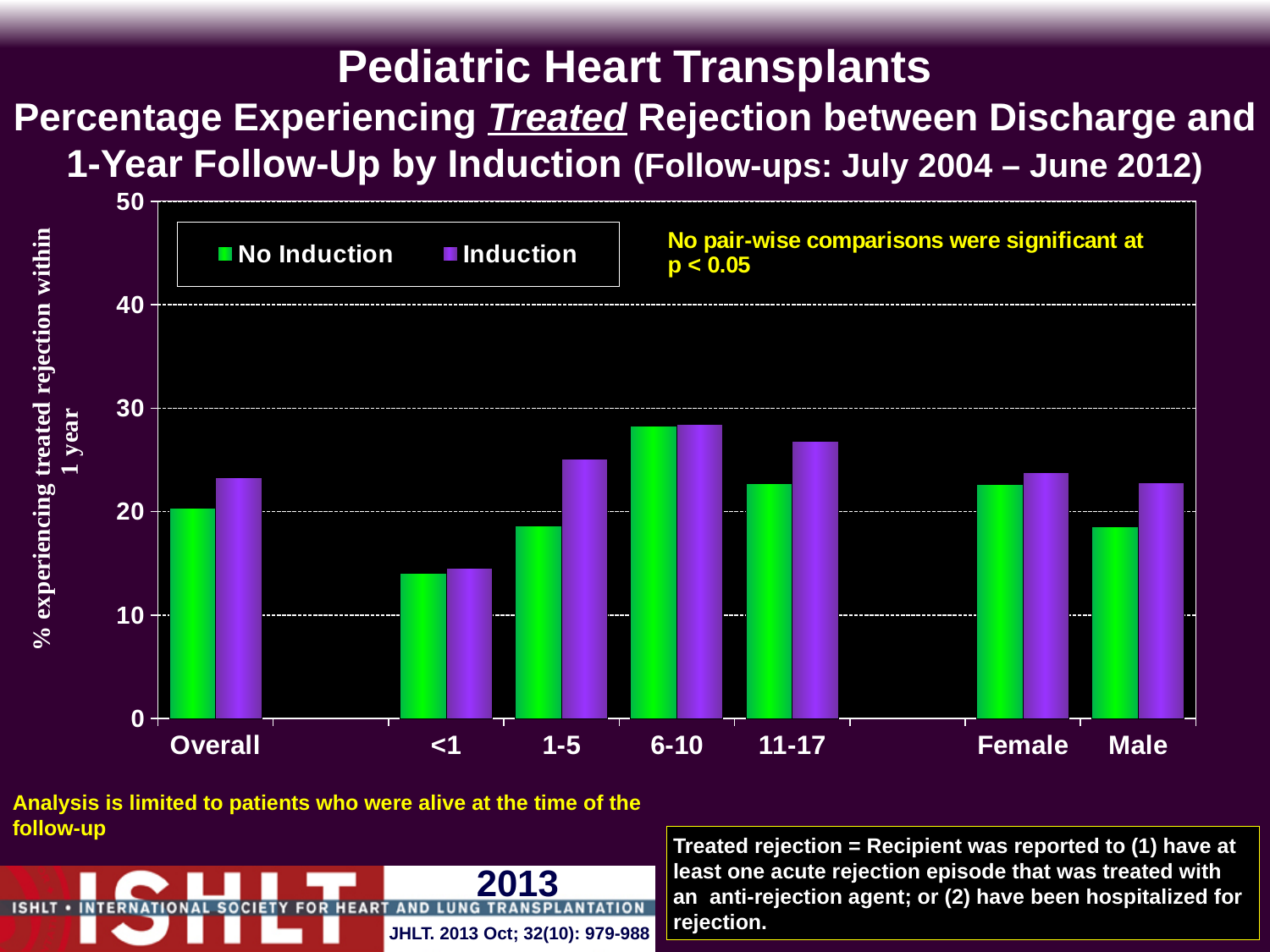
Which category has the highest value for the No Induction series? 6-10 Is the No Induction value for Male greater or less than 20? less What kind of chart is shown on the slide? bar chart Which category has the lowest value for the Induction series? <1 Which category has the lowest value for the No Induction series? <1 For the 11-17 age group, which series has the larger value, No Induction or Induction? Induction How many categories are shown along the x axis? 7 Is the No Induction value for 6-10 greater or less than 30? less What colour are the bars for the Induction series? purple Is the Induction value for Overall greater or less than 20? greater How many series does the legend list? 2 For the 1-5 age group, which series has the larger value, No Induction or Induction? Induction